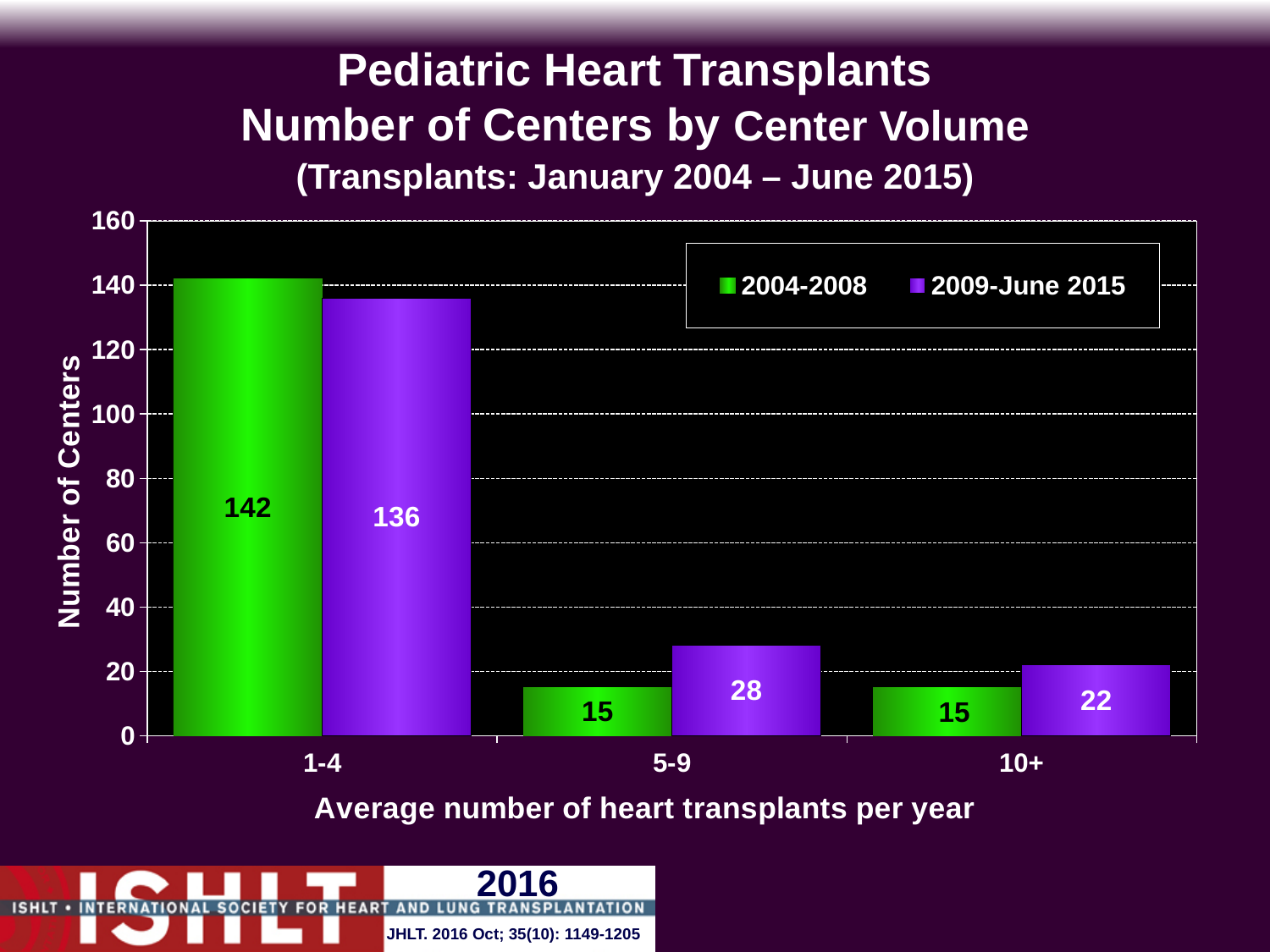
What is the difference between the 2004-2008 and 2009-June 2015 values for the 1-4 category? 6 What kind of chart is shown on the slide? bar chart How many series does the legend list? 2 Which center volume category has the highest number of centers in the 2009-June 2015 series? 1-4 What is the number of centers with 10+ average heart transplants per year in 2004-2008? 15 What is the number of centers with 1-4 average heart transplants per year in 2004-2008? 142 Which is larger for the 5-9 category: the 2004-2008 value or the 2009-June 2015 value? 2009-June 2015 Which center volume category has the lowest number of centers in the 2009-June 2015 series? 10+ What is the difference between the 2009-June 2015 values for the 5-9 and 10+ categories? 6 How many center volume categories are shown on the x axis? 3 What is the label of the y axis? Number of Centers What is the number of centers with 5-9 average heart transplants per year in 2009-June 2015? 28